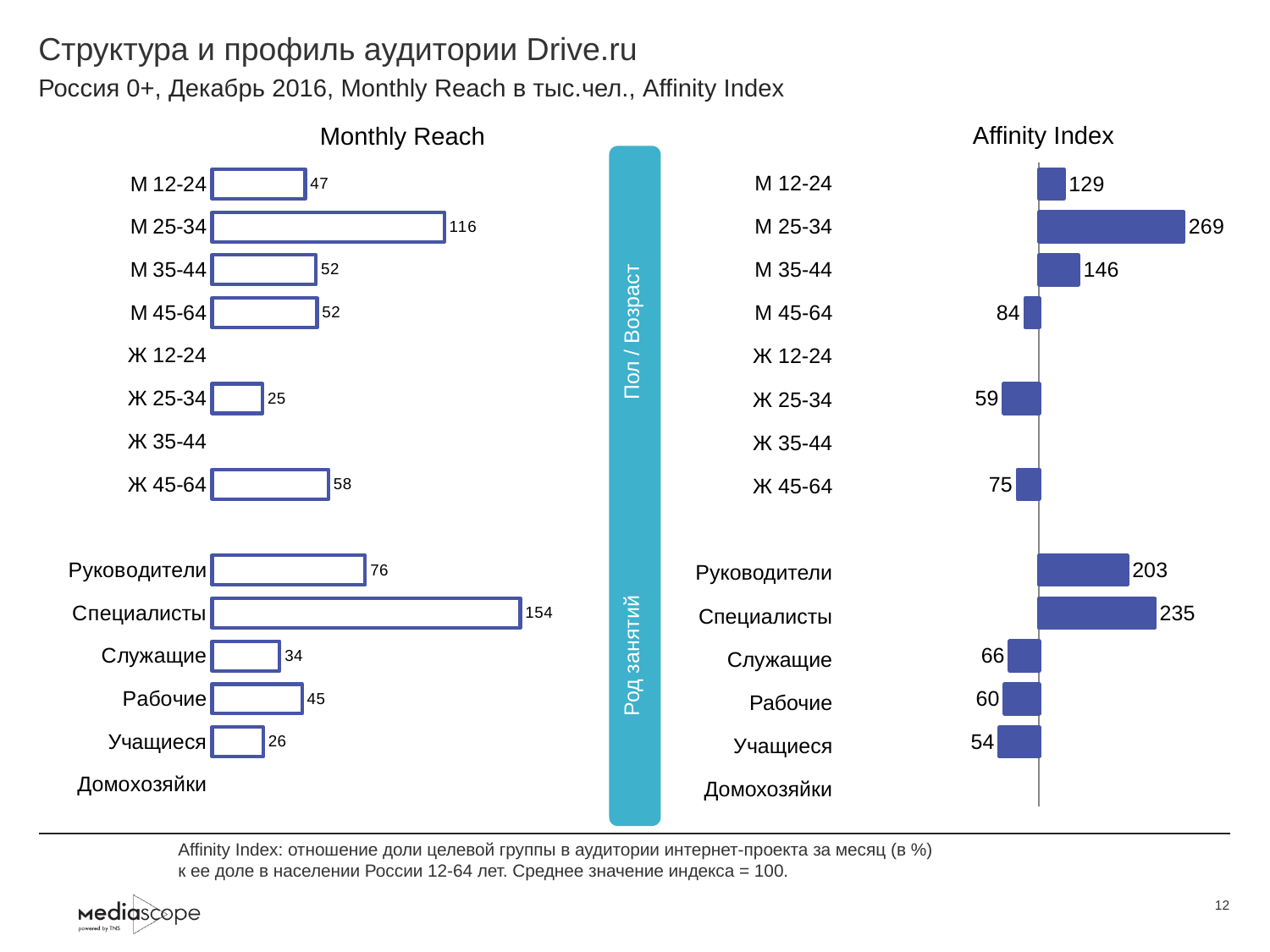
In the Monthly Reach chart, which is larger, Рабочие or Служащие? Рабочие In the Affinity Index chart, which category has the highest value? М 25-34 In the Affinity Index chart, what is the value for Специалисты? 235 In the Monthly Reach chart, what is the value for М 25-34? 116 In the Affinity Index chart, what is the value for М 45-64? 84 In the Affinity Index chart, which category among those with a plotted bar has the lowest value? Учащиеся In the Monthly Reach chart, which category has the highest value? Специалисты In the Affinity Index chart, what is the difference between М 25-34 and М 12-24? 140 In the Monthly Reach chart, which category among those with a plotted bar has the lowest value? Ж 25-34 What type of chart is the Monthly Reach chart? Bar chart In the Monthly Reach chart, what is the difference between Специалисты and Руководители? 78 In the Affinity Index chart, which is larger, Руководители or М 35-44? Руководители